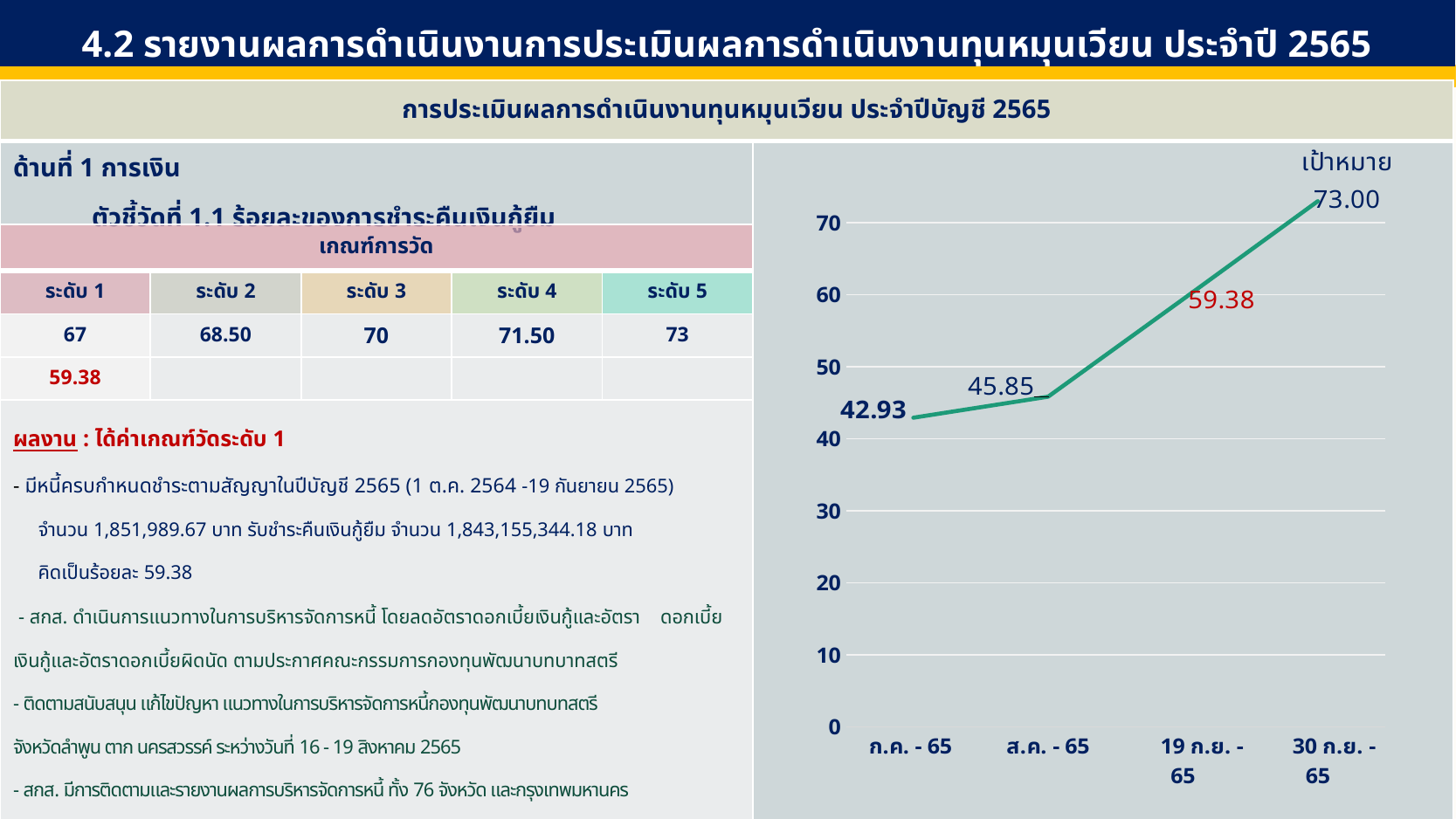
Which x-axis category has the lowest value on the line chart? ก.ค. - 65 What is the value plotted for 19 ก.ย. - 65? 59.38 What kind of chart is shown on the right side of the slide? line chart Which x-axis category has the highest value on the line chart? 30 ก.ย. - 65 How many data points are plotted on the line chart? 4 Is the value for 19 ก.ย. - 65 greater or less than 50? greater Do the values on the line chart rise or fall from left to right along the x axis? rise What is the value plotted for ส.ค. - 65? 45.85 What is the difference between the values for 19 ก.ย. - 65 and ส.ค. - 65? 13.53 What is the value plotted for 30 ก.ย. - 65? 73.00 Which is larger, the value for ส.ค. - 65 or the value for ก.ค. - 65? ส.ค. - 65 What is the value plotted for ก.ค. - 65? 42.93